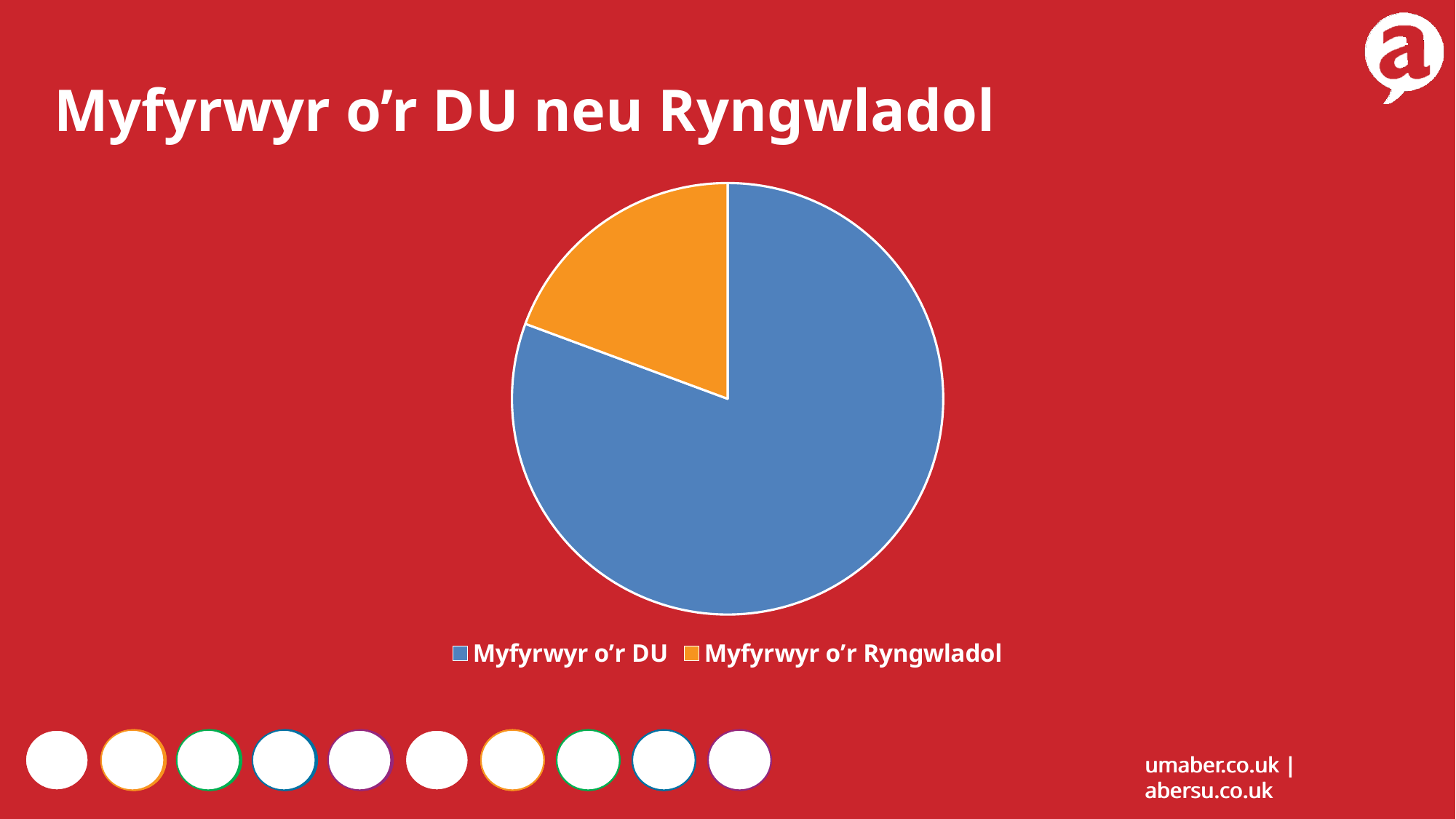
How many slices does the pie chart have? 2 Which category has the smallest slice of the pie chart? Myfyrwyr o’r Ryngwladol What kind of chart is shown on the slide? Pie chart Which category has the largest slice of the pie chart? Myfyrwyr o’r DU Does the slice for Myfyrwyr o’r DU take up more or less than half of the pie? More What colour is the slice for Myfyrwyr o’r Ryngwladol in the pie chart? Orange How many entries does the legend of the pie chart list? 2 Which slice is larger: Myfyrwyr o’r DU or Myfyrwyr o’r Ryngwladol? Myfyrwyr o’r DU What is the title of the slide containing the pie chart? Myfyrwyr o’r DU neu Ryngwladol